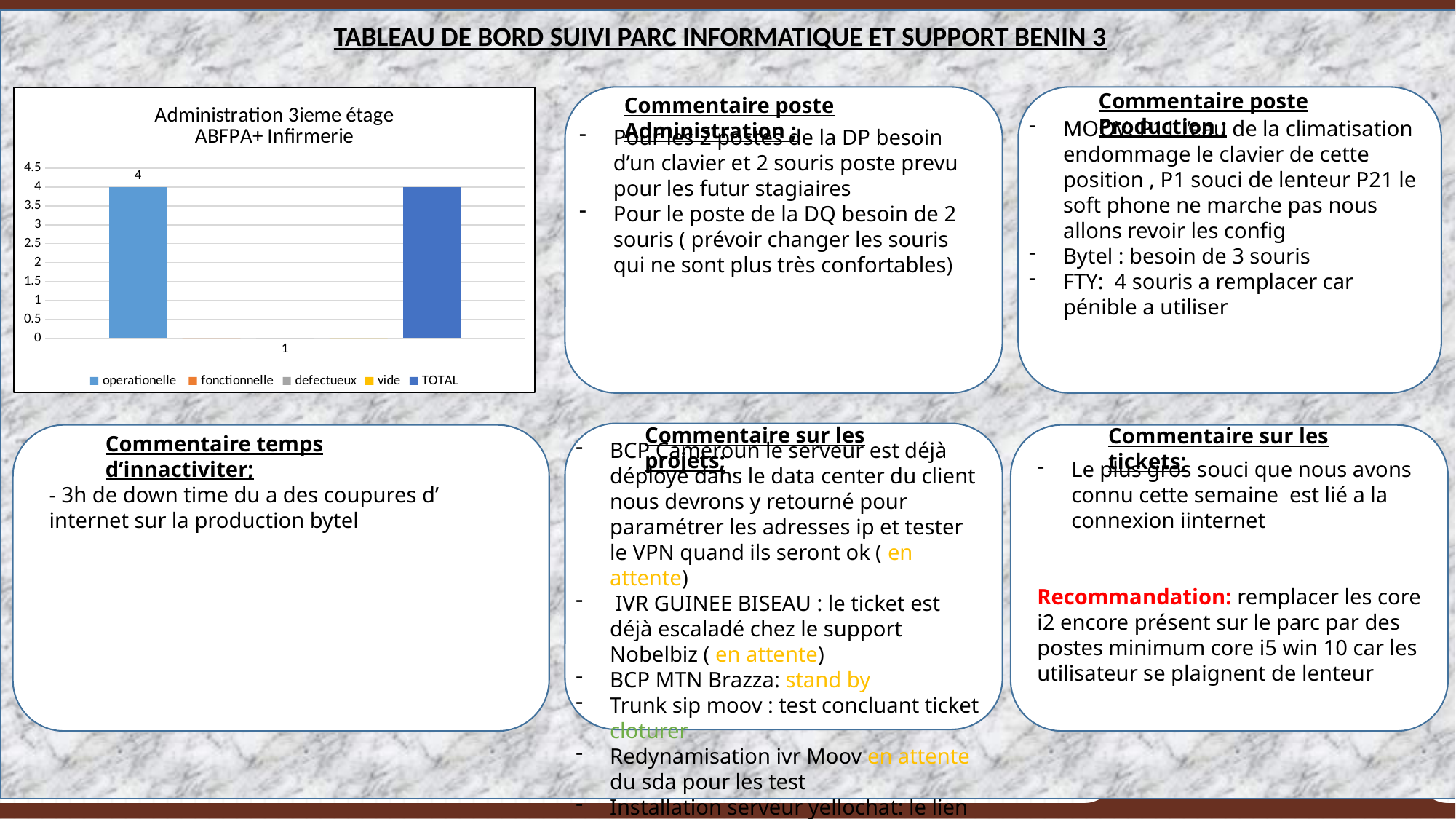
What is the title of the chart? Administration 3ieme étage ABFPA+ Infirmerie How many categories are shown on the x axis of the chart? 1 Is the value for operationelle greater or less than 3? greater What is the value of the TOTAL bar? 4 Which series is listed first in the chart legend? operationelle What kind of chart is shown on the slide? bar chart What is the highest value shown on the vertical axis? 4.5 What is the value of the operationelle bar? 4 How many series does the chart legend list? 5 Which is larger, the operationelle bar or the fonctionnelle bar? operationelle Is the value for TOTAL greater or less than 2? greater